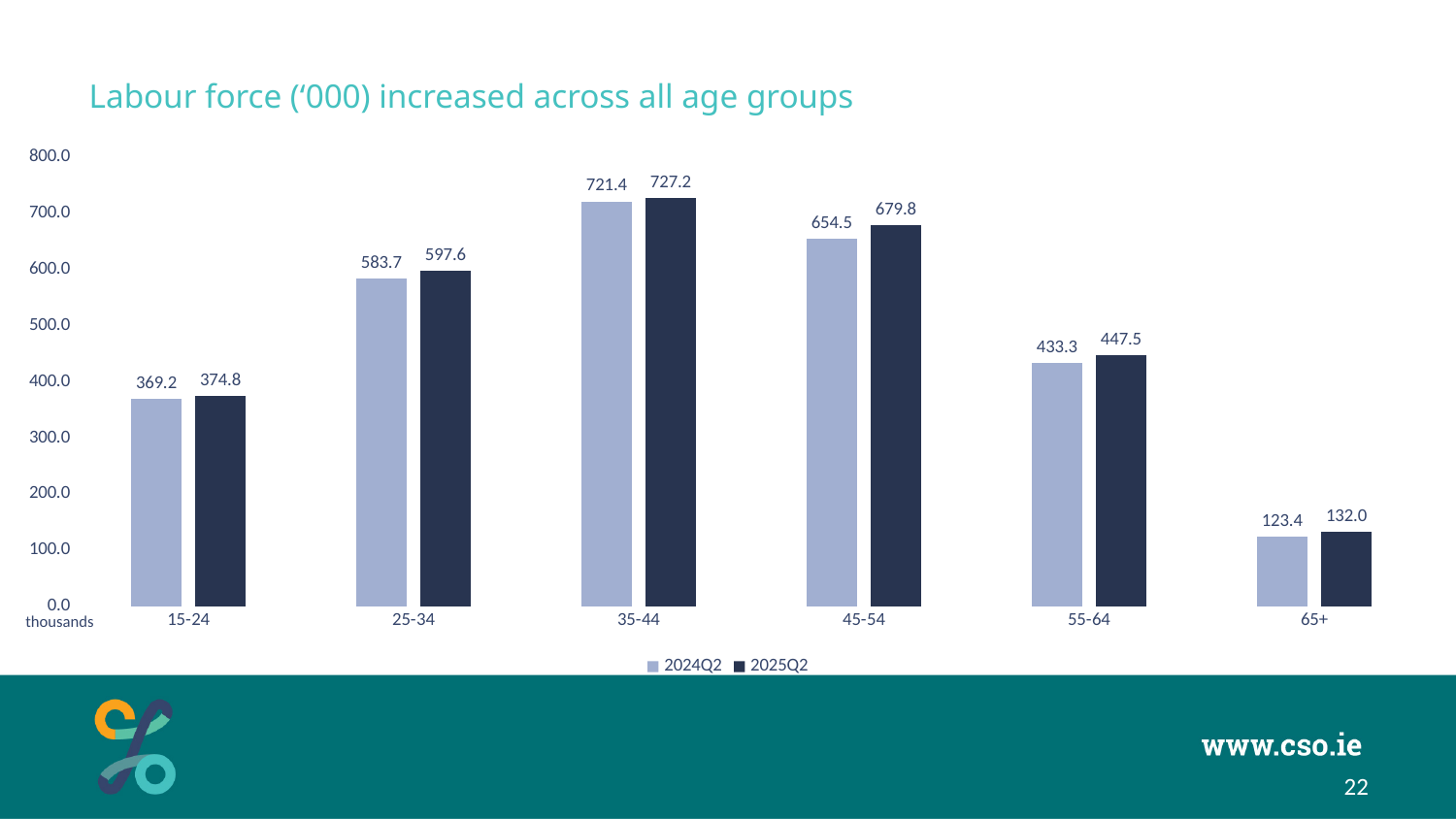
How many age groups are shown on the x axis? 6 Is the 2025Q2 value for the 25-34 age group greater or less than 500.0? greater What is the labour force value for the 65+ age group in 2025Q2? 132.0 Which age group has the highest labour force value in 2025Q2? 35-44 What is the labour force value for the 55-64 age group in 2024Q2? 433.3 What is the difference between the 2025Q2 and 2024Q2 values for the 45-54 age group? 25.3 What kind of chart is shown on the slide? bar chart What is the labour force value for the 35-44 age group in 2025Q2? 727.2 Which age group has the lowest labour force value in 2024Q2? 65+ What is the title of the chart? Labour force ('000) increased across all age groups How many series does the legend list? 2 Which is larger: the 2024Q2 value for 25-34 or the 2025Q2 value for 55-64? 2024Q2 value for 25-34